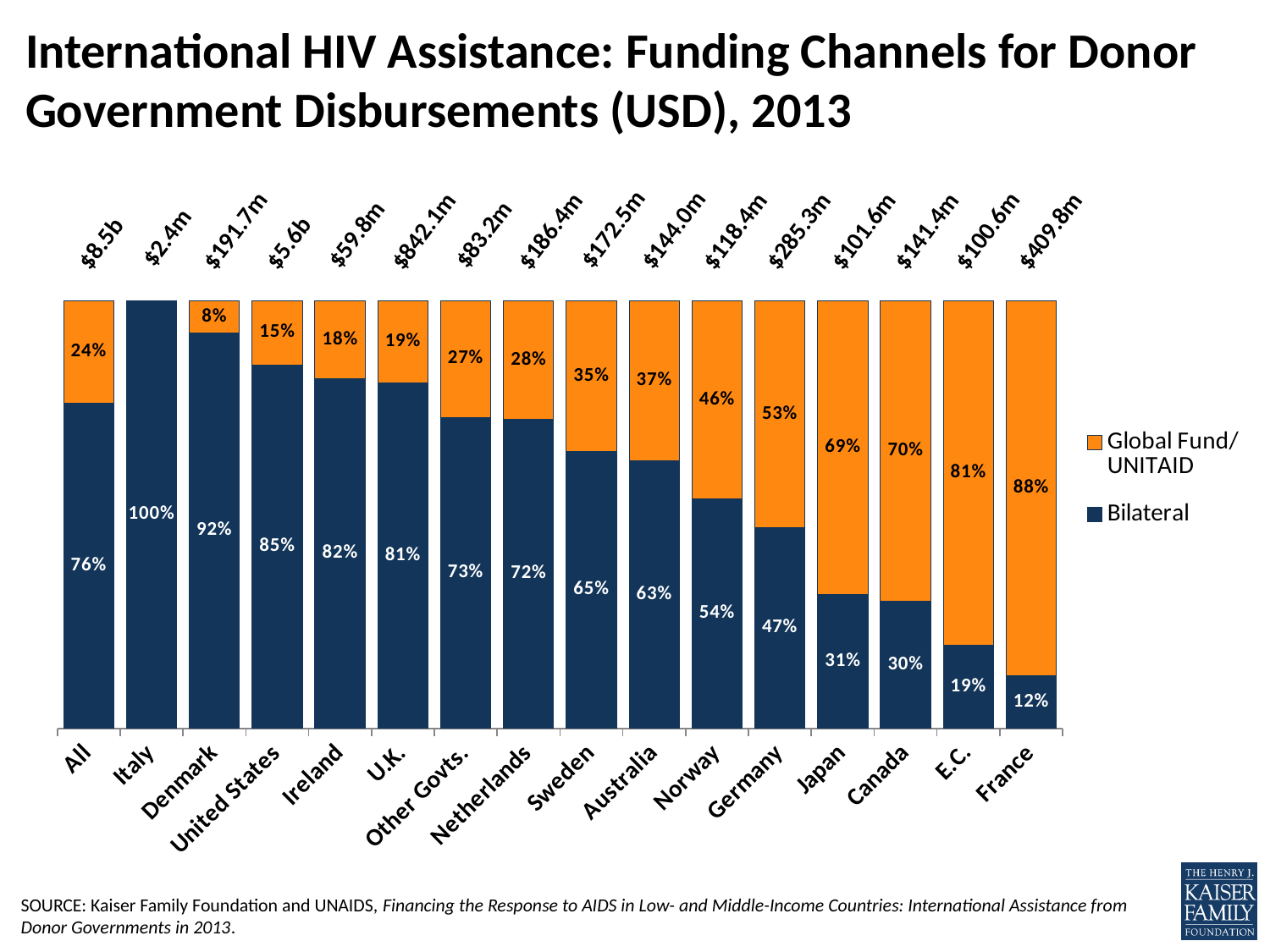
What colour represents the Global Fund/UNITAID series? Orange What is the Global Fund/UNITAID share for Japan? 69% How many series does the legend list? 2 Which has a larger Global Fund/UNITAID share, Norway or Sweden? Norway What kind of chart is shown on the slide? Stacked bar chart What is the Bilateral share for Germany? 47% How many categories are shown on the x axis? 16 Does the Bilateral share generally rise or fall moving from left to right across the x axis? Fall What is the difference between the Bilateral share for the United States and the Bilateral share for Canada? 55% Which country has the lowest Bilateral share? France Which country has the highest Bilateral share? Italy What total disbursement amount is shown above the France bar? $409.8m